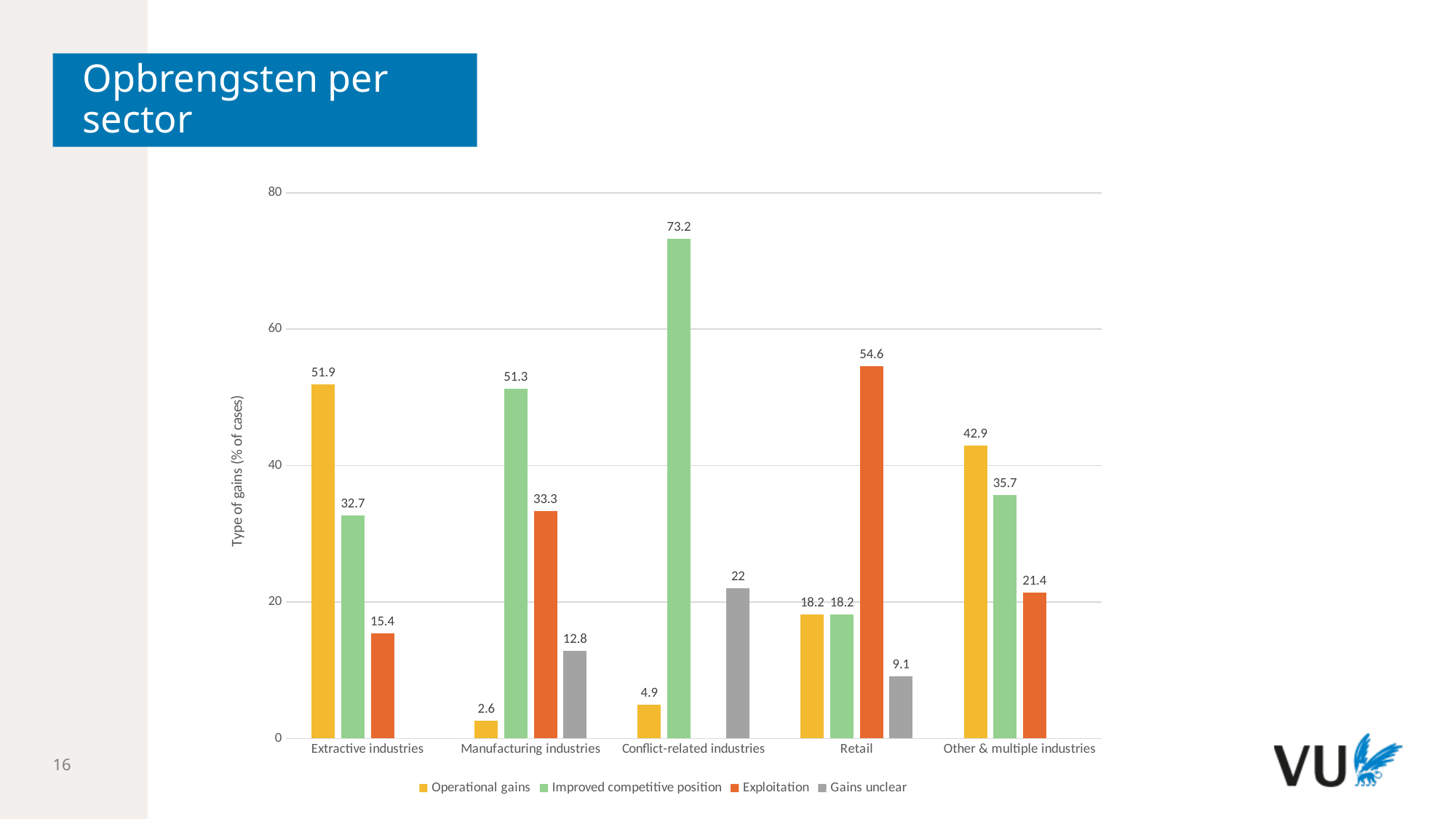
What is the difference between Improved competitive position and Exploitation in Manufacturing industries? 18 What is the value for Improved competitive position in Conflict-related industries? 73.2 Which is larger in Other & multiple industries: Operational gains or Improved competitive position? Operational gains Which sector has the highest value for Operational gains? Extractive industries What is the label of the vertical axis? Type of gains (% of cases) What is the value for Operational gains in Manufacturing industries? 2.6 What is the value for Gains unclear in Conflict-related industries? 22 What is the value for Exploitation in Retail? 54.6 How many series does the legend list? 4 Which sector has the lowest value for Improved competitive position? Retail What kind of chart is shown on the slide? Bar chart How many sectors are shown on the x axis? 5